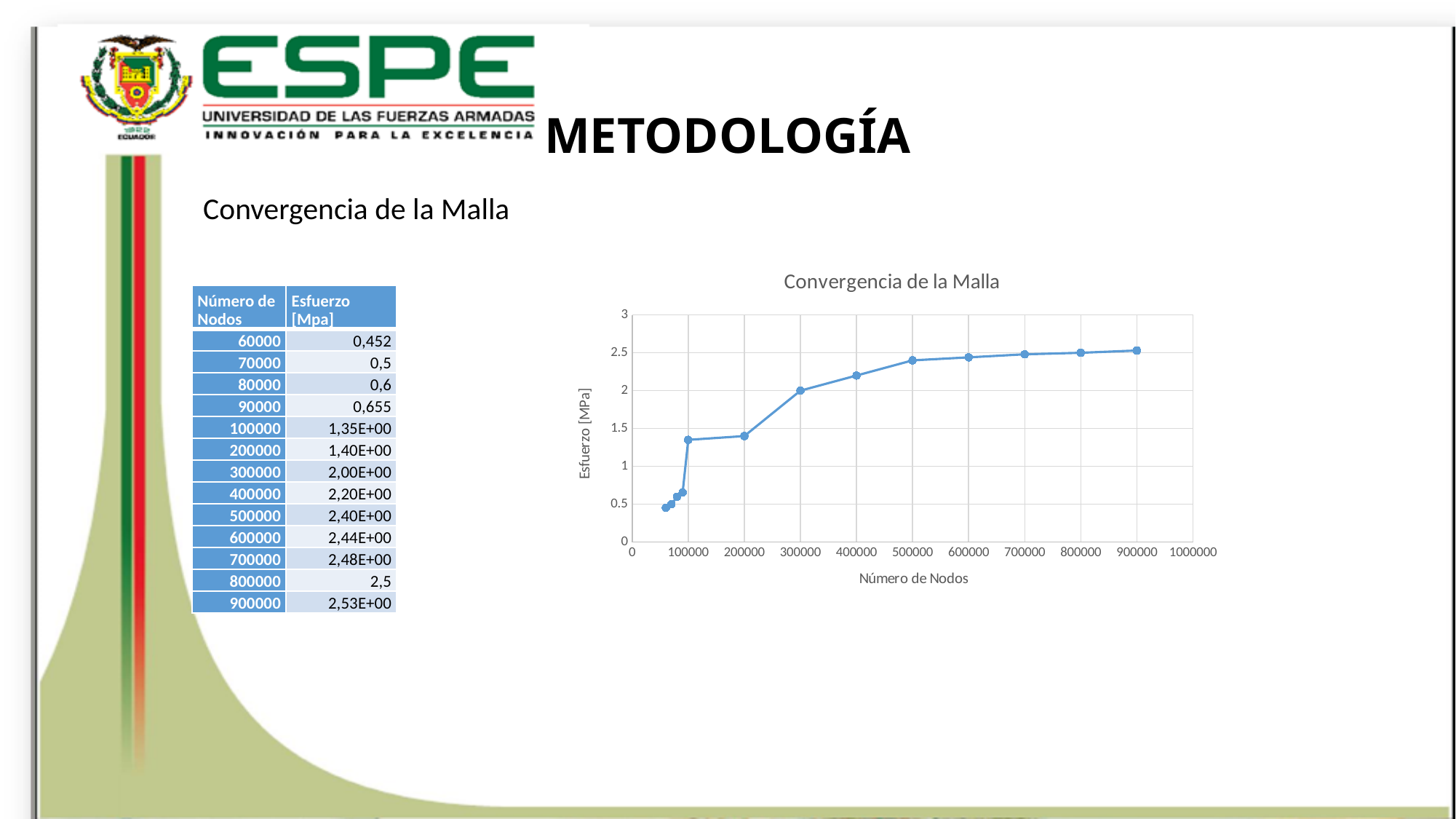
What is the title of the chart? Convergencia de la Malla At which number of nodes is the Esfuerzo value highest? 900000 What is the difference between the Esfuerzo values at 80000 nodes and 70000 nodes, as given in the table? 0,1 What is the label of the y axis of the chart? Esfuerzo [MPa] What kind of chart is shown on the slide? line chart Is the Esfuerzo value at 60000 nodes greater or less than 1? less Is the Esfuerzo value at 300000 nodes greater or less than 1.5? greater At which number of nodes is the Esfuerzo value lowest? 60000 Which has the larger Esfuerzo value: 200000 nodes or 500000 nodes? 500000 nodes What is the Esfuerzo value at 800000 nodes, as given in the table? 2,5 Do the values rise or fall as the number of nodes increases along the x axis? rise How many data points are plotted on the chart? 13